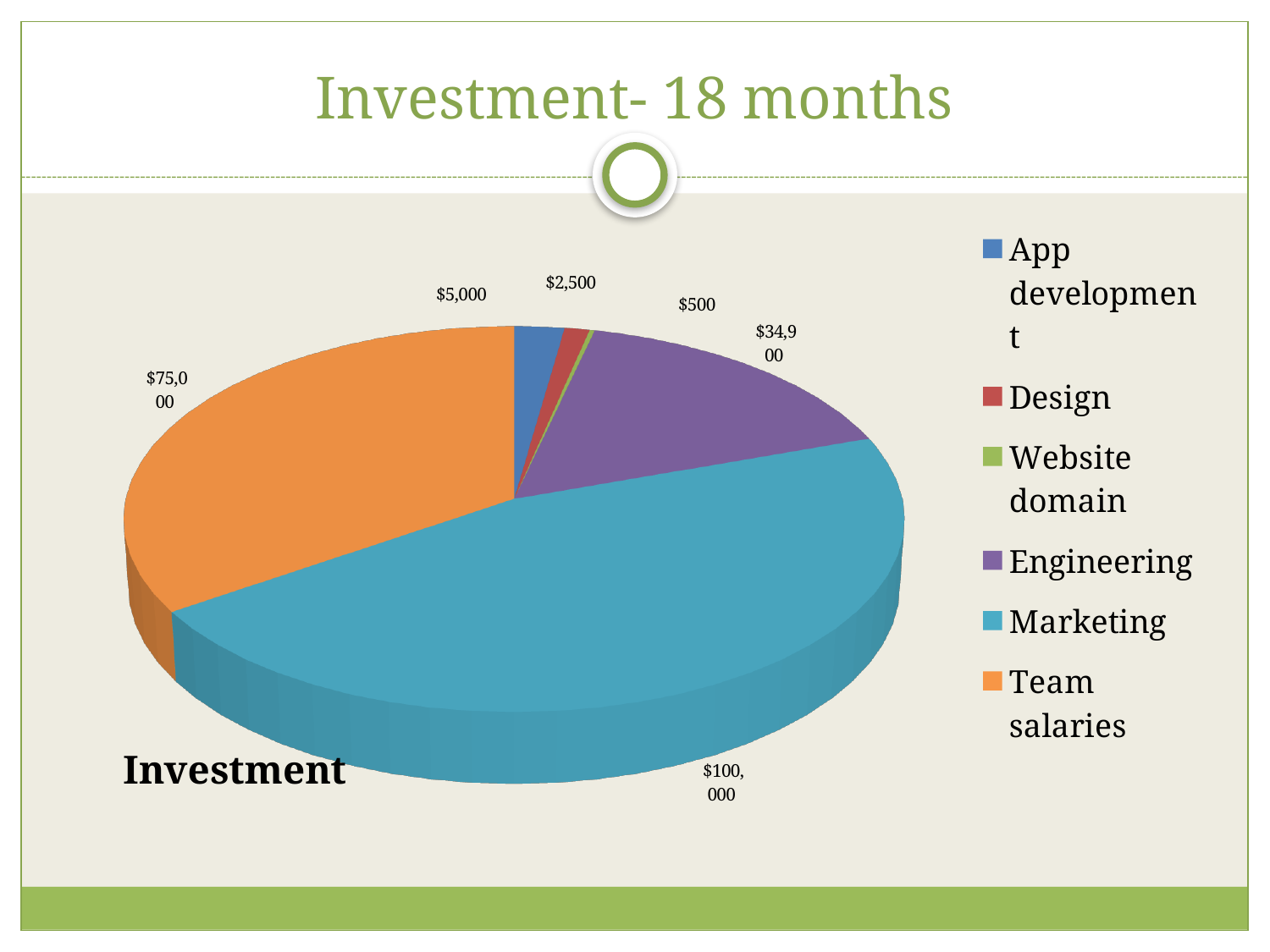
What is the value for Website domain? $500 What is the value for Team salaries? $75,000 How many categories does the legend list? 6 What is the value for Marketing? $100,000 Which category has the smallest slice? Website domain Which is larger, App development or Design? App development What is the difference between Marketing and Team salaries? $25,000 Which category has the largest slice? Marketing What is the total of all slices in the pie? $217,900 What is the value for Engineering? $34,900 What type of chart is shown on the slide? Pie chart What is the title of the chart? Investment